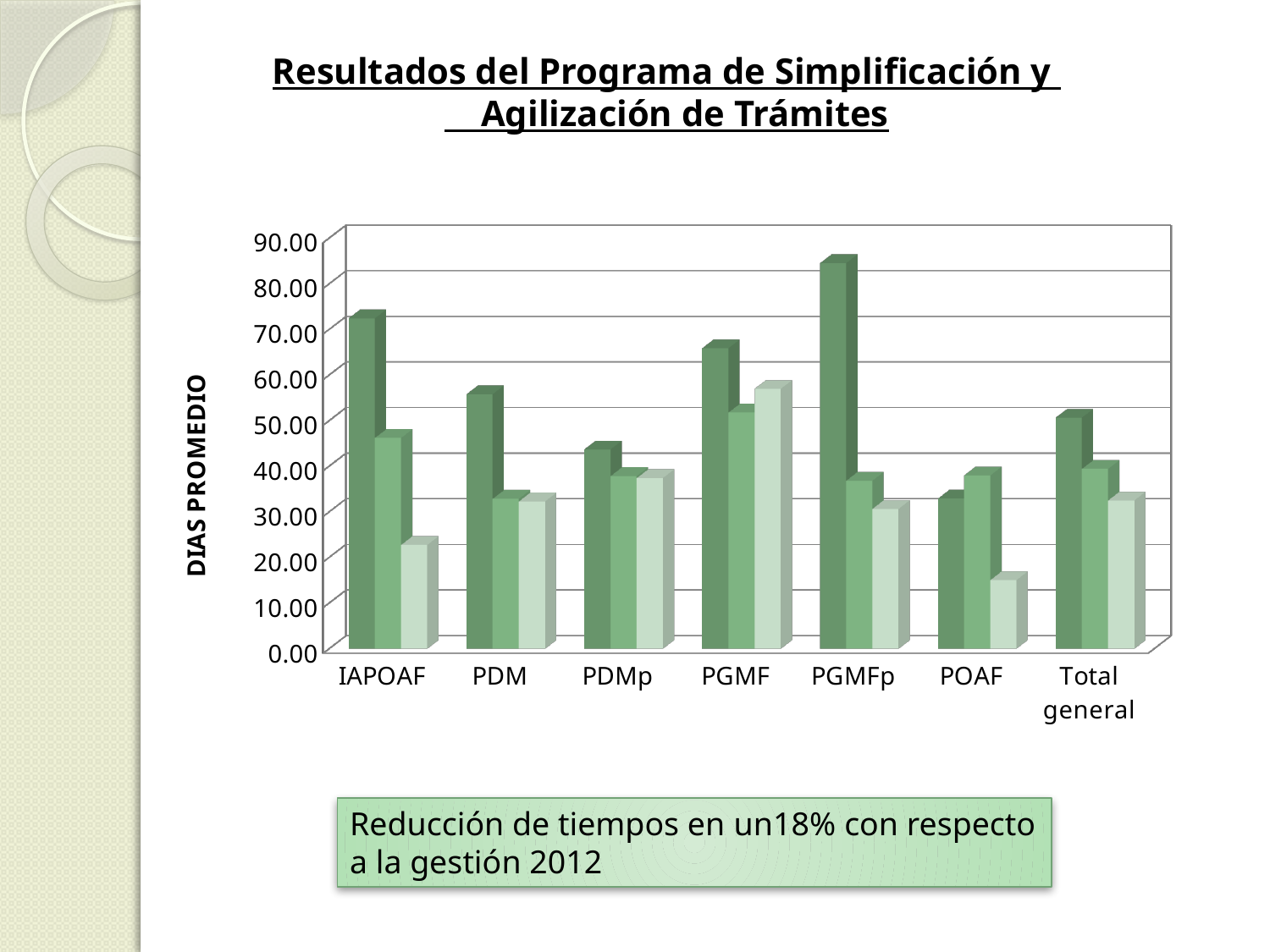
Which category has the shortest light green (third) bar? POAF How many categories are shown along the x axis of the chart? 7 Is the light green (third) bar for POAF greater or less than 20? less Is the dark green (first) bar for IAPOAF greater or less than 70? greater Is the light green (third) bar for IAPOAF greater or less than 30? less Which category has the tallest dark green (first) bar? PGMFp What is the title of the vertical axis of the chart? DIAS PROMEDIO What kind of chart is shown on the slide? bar chart Which is larger, the light green (third) bar for PGMF or the light green (third) bar for PGMFp? PGMF Which is larger, the dark green (first) bar for PGMF or the dark green (first) bar for PDM? PGMF What is the title of the slide? Resultados del Programa de Simplificación y Agilización de Trámites